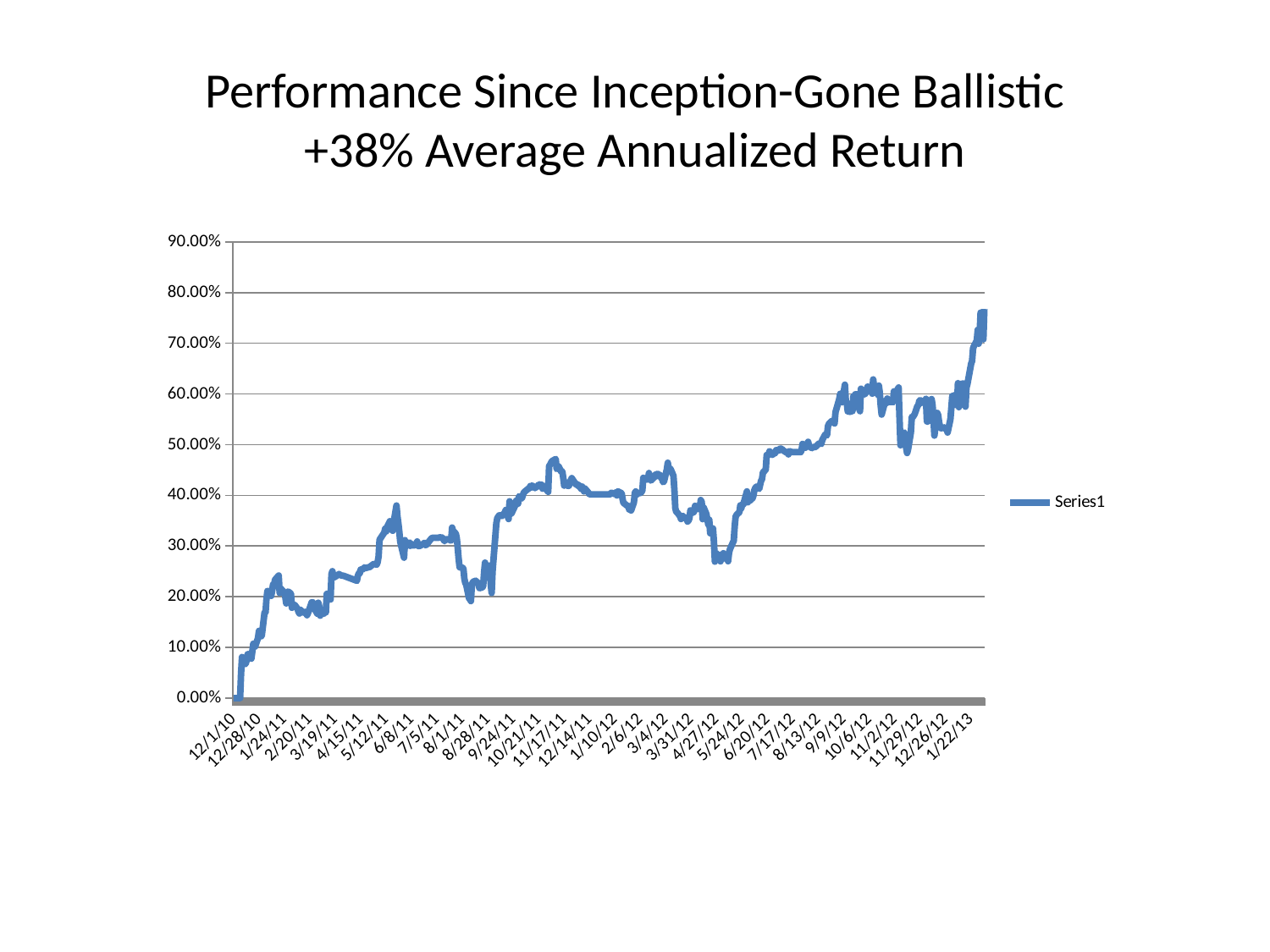
Which of the two dates has the larger value, 12/28/10 or 1/22/13? 1/22/13 Is the value at 1/22/13 greater or less than 70.00%? less Is the value at 7/17/12 greater or less than 40.00%? greater Overall, do the values rise or fall from the left of the x axis to the right? rise What is the title of the chart on the slide? Performance Since Inception-Gone Ballistic +38% Average Annualized Return What is the name of the series shown in the legend? Series1 How many series does the legend list? 1 What kind of chart is shown on the slide? line chart Is the value at 2/20/11 greater or less than 20.00%? less How many date labels are shown along the x axis? 30